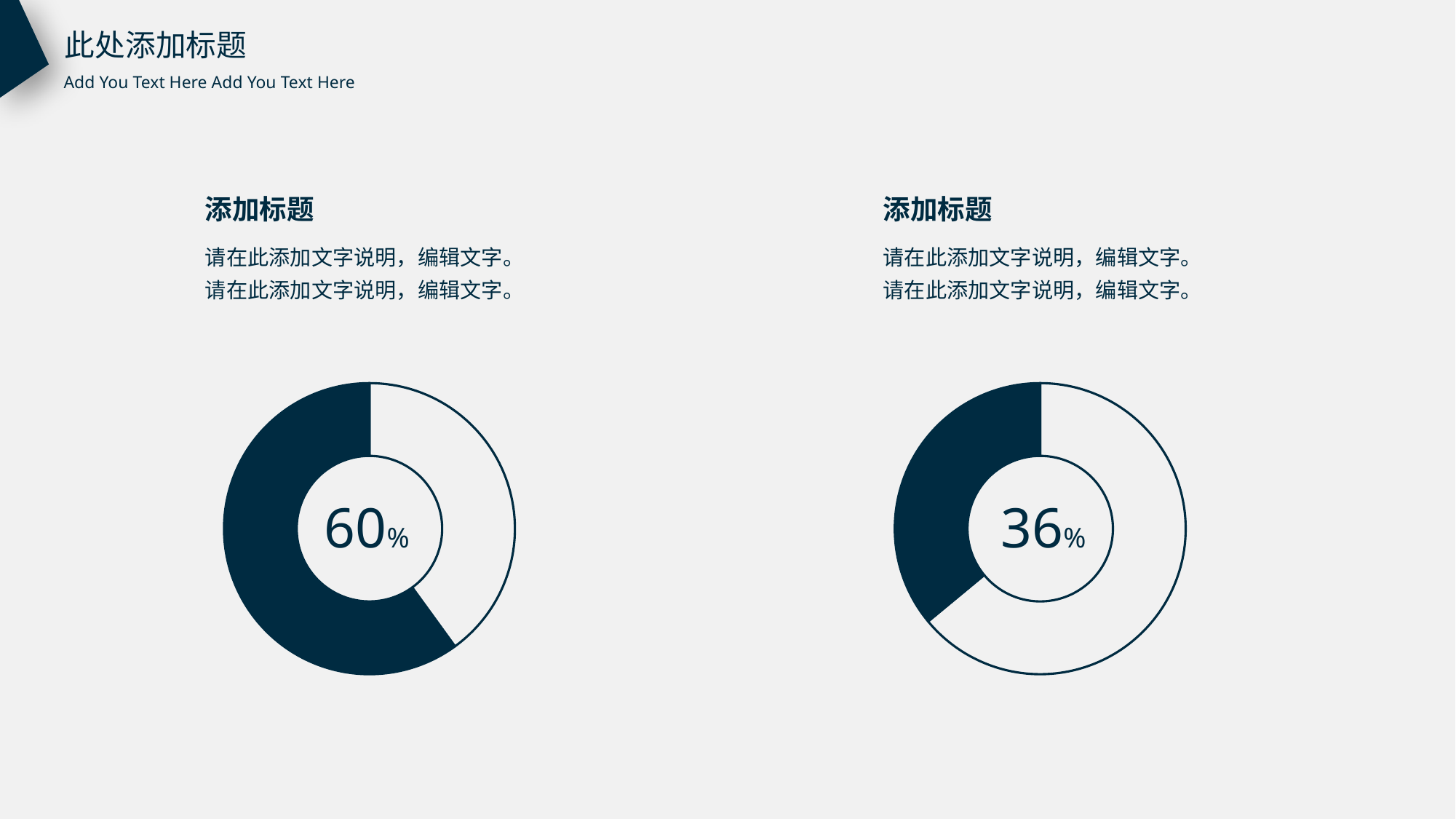
What kind of chart is used on the right side of the slide? donut chart What percentage is shown in the centre of the right donut chart? 36% How many donut charts are on the slide? 2 Is the value shown on the left donut chart greater or less than 50%? greater Which donut chart shows the larger percentage, the left one or the right one? the left one What is the difference between the percentage on the left donut chart and the percentage on the right donut chart? 24 percentage points Is the value shown on the right donut chart greater or less than 50%? less On the right donut chart, what share of the ring is not filled by the dark segment? 64% On the left donut chart, what share of the ring is not filled by the dark segment? 40% What kind of chart is used on the left side of the slide? donut chart What percentage is shown in the centre of the left donut chart? 60% What colour is the filled segment of each donut chart? dark navy blue